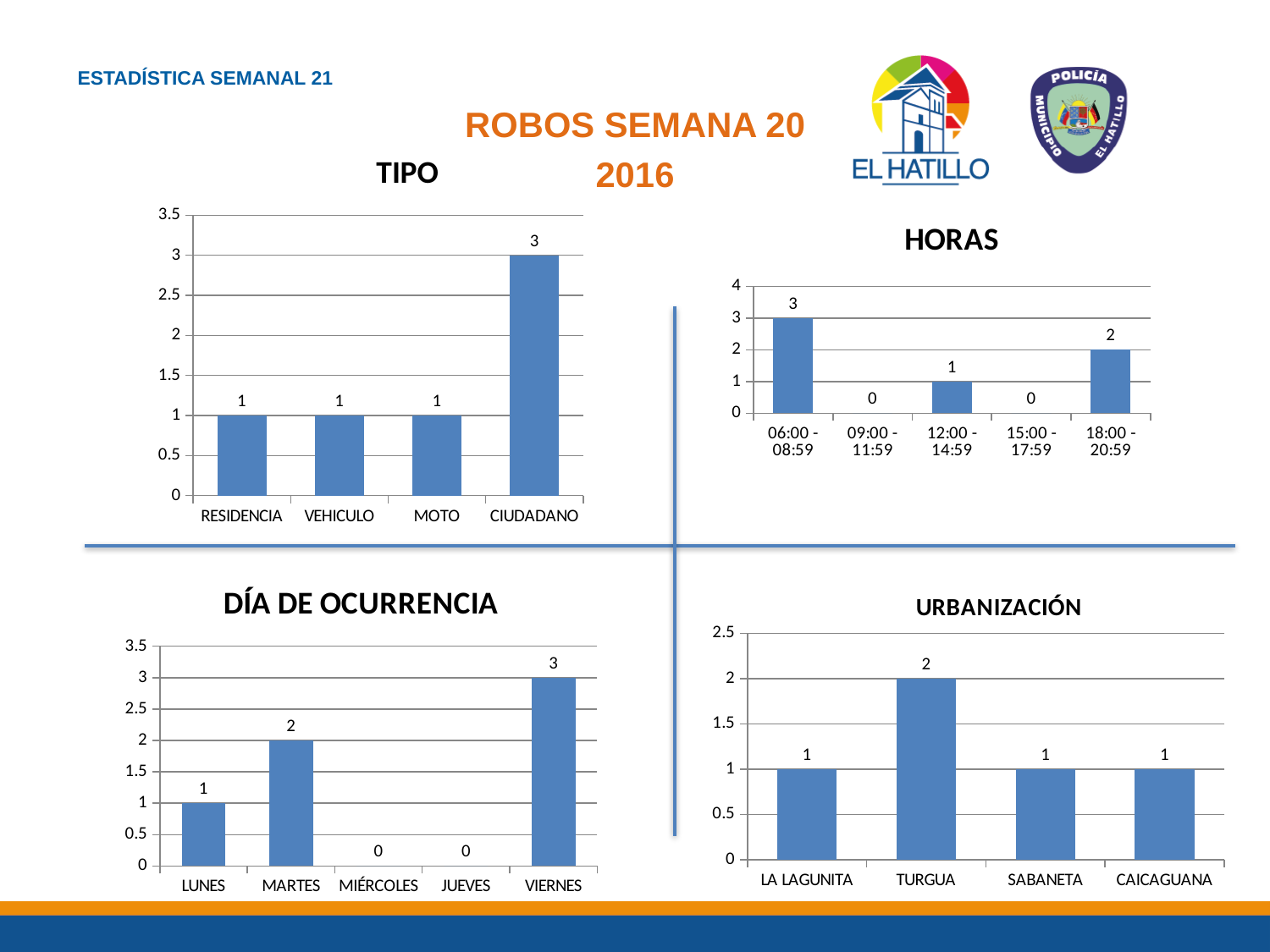
In the URBANIZACIÓN chart, which is larger, the value for TURGUA or the value for SABANETA? TURGUA In the DÍA DE OCURRENCIA chart, what is the value for MARTES? 2 In the TIPO chart, how many categories are shown? 4 In the TIPO chart, what is the value for CIUDADANO? 3 In the HORAS chart, which time slot has the highest value? 06:00 - 08:59 In the DÍA DE OCURRENCIA chart, how many days are shown on the x axis? 5 In the HORAS chart, what is the value for 18:00 - 20:59? 2 In the URBANIZACIÓN chart, which category has the highest value? TURGUA In the DÍA DE OCURRENCIA chart, which day has the highest value? VIERNES What kind of chart is the URBANIZACIÓN chart? Bar chart In the HORAS chart, what is the difference between the values for 06:00 - 08:59 and 12:00 - 14:59? 2